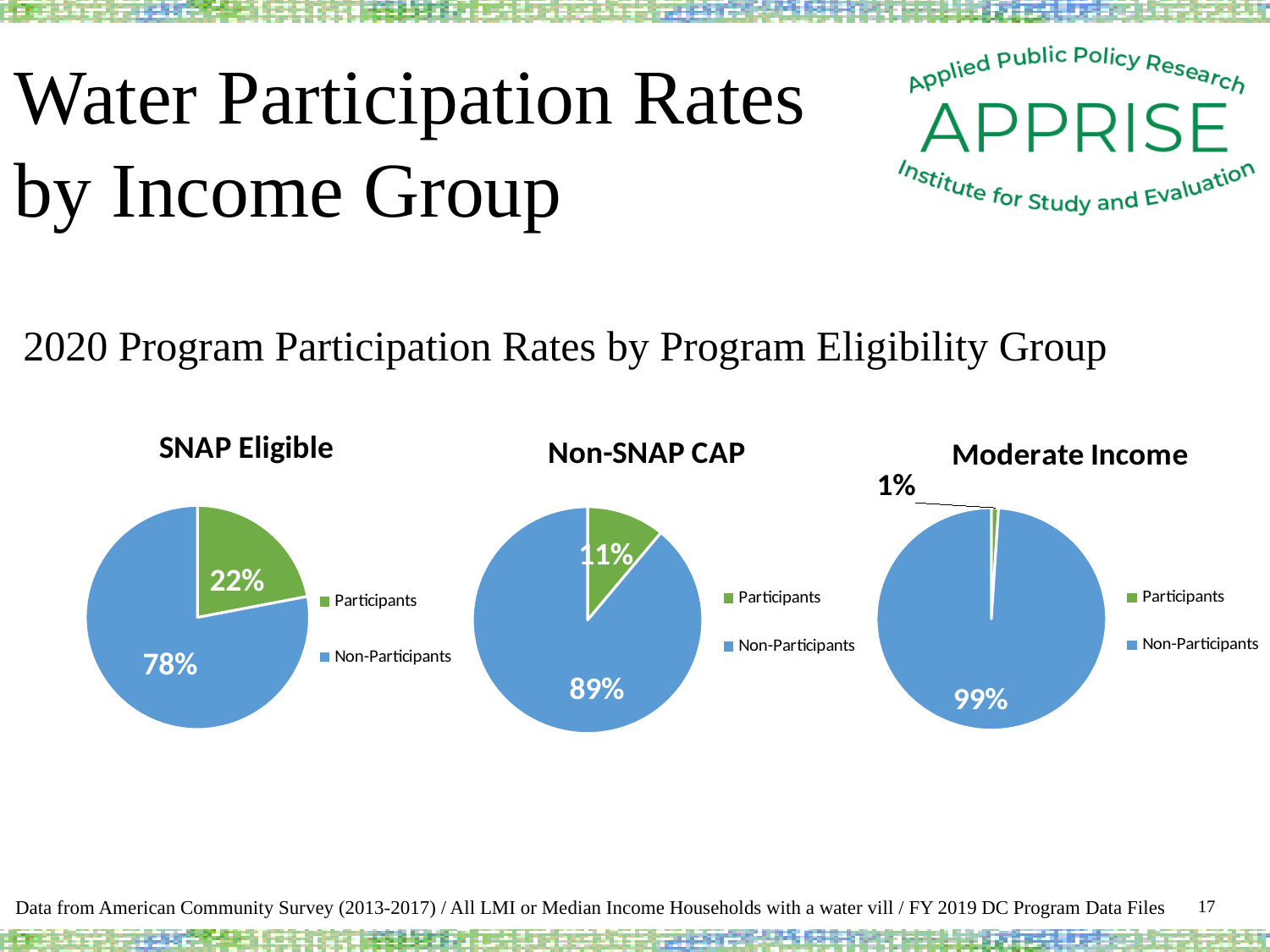
How many pie charts are shown on the slide? 3 In the Non-SNAP CAP pie chart, what share is labelled for Participants? 11% In the Non-SNAP CAP pie chart, what share is labelled for Non-Participants? 89% In the Moderate Income pie chart, what share is labelled for Non-Participants? 99% In the SNAP Eligible pie chart, what share is labelled for Participants? 22% How many entries does the legend of the Non-SNAP CAP pie chart list? 2 In the Moderate Income pie chart, what share is labelled for Participants? 1% What kind of chart is used for the SNAP Eligible group? Pie chart In the SNAP Eligible pie chart, what share is labelled for Non-Participants? 78% Which pie chart shows the largest Participants share: SNAP Eligible, Non-SNAP CAP, or Moderate Income? SNAP Eligible Which colour represents Non-Participants in the pie charts? Blue What is the difference between the Participants share in the SNAP Eligible chart and the Participants share in the Non-SNAP CAP chart? 11%